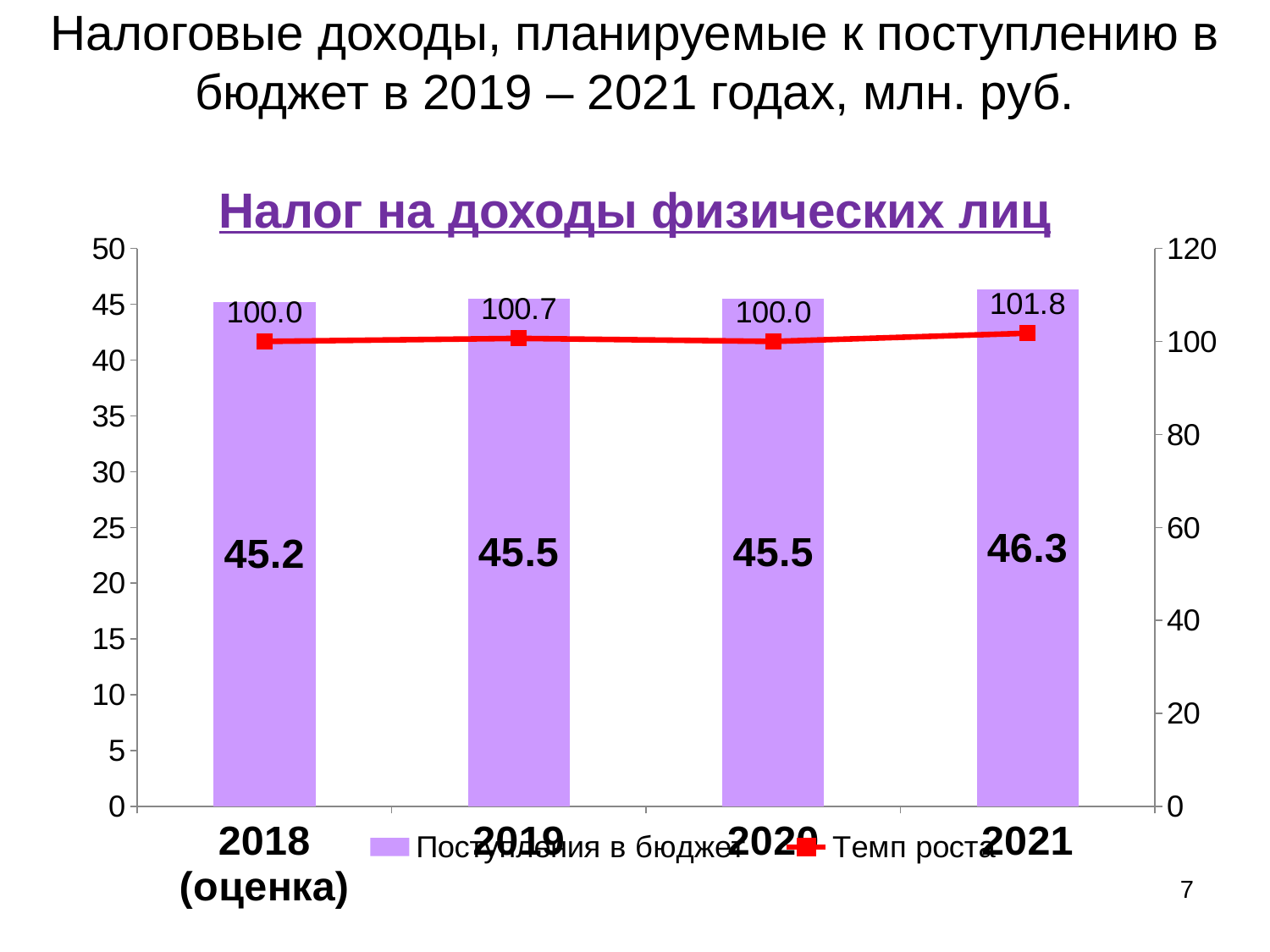
Which year has the highest value of 'Поступления в бюджет'? 2021 What colour are the bars for 'Поступления в бюджет'? Purple What is the value of 'Темп роста' for 2019? 100.7 What is the value of 'Поступления в бюджет' for 2019? 45.5 What is the value of 'Темп роста' for 2021? 101.8 How many years are shown on the x axis? 4 What is the difference between the 'Поступления в бюджет' values for 2021 and 2018 (оценка)? 1.1 How many series does the legend list? 2 Which is larger: the 'Темп роста' value for 2019 or for 2021? 2021 What is the title of the chart? Налог на доходы физических лиц Which year has the lowest value of 'Поступления в бюджет'? 2018 (оценка) What is the value of 'Поступления в бюджет' for 2021? 46.3